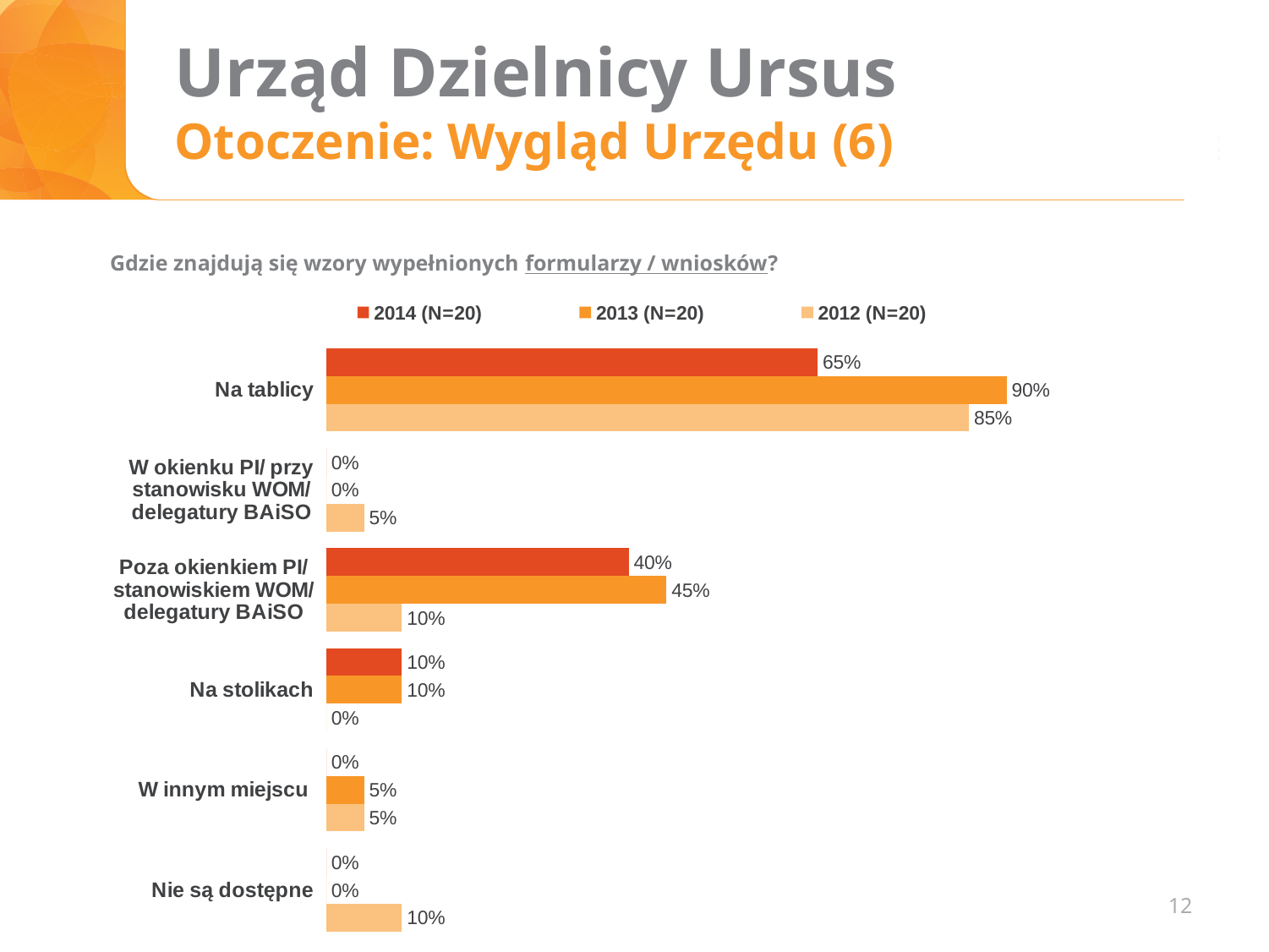
What is the difference between the 2013 (N=20) and 2014 (N=20) values for "Na tablicy"? 25% What is the value for "Poza okienkiem PI/ stanowiskiem WOM/ delegatury BAiSO" in the 2012 (N=20) series? 10% How many series does the legend list? 3 How many categories are shown on the chart? 6 For "Na tablicy", which is larger: the 2012 (N=20) value or the 2014 (N=20) value? 2012 (N=20) What kind of chart is shown on the slide? Bar chart What is the value for "Nie są dostępne" in the 2012 (N=20) series? 10% What is the difference between the 2013 (N=20) and 2012 (N=20) values for "Poza okienkiem PI/ stanowiskiem WOM/ delegatury BAiSO"? 35% What is the value for "Na tablicy" in the 2013 (N=20) series? 90% What is the value for "Na tablicy" in the 2014 (N=20) series? 65% What is the value for "W innym miejscu" in the 2013 (N=20) series? 5% Which category has the highest value in the 2013 (N=20) series? Na tablicy